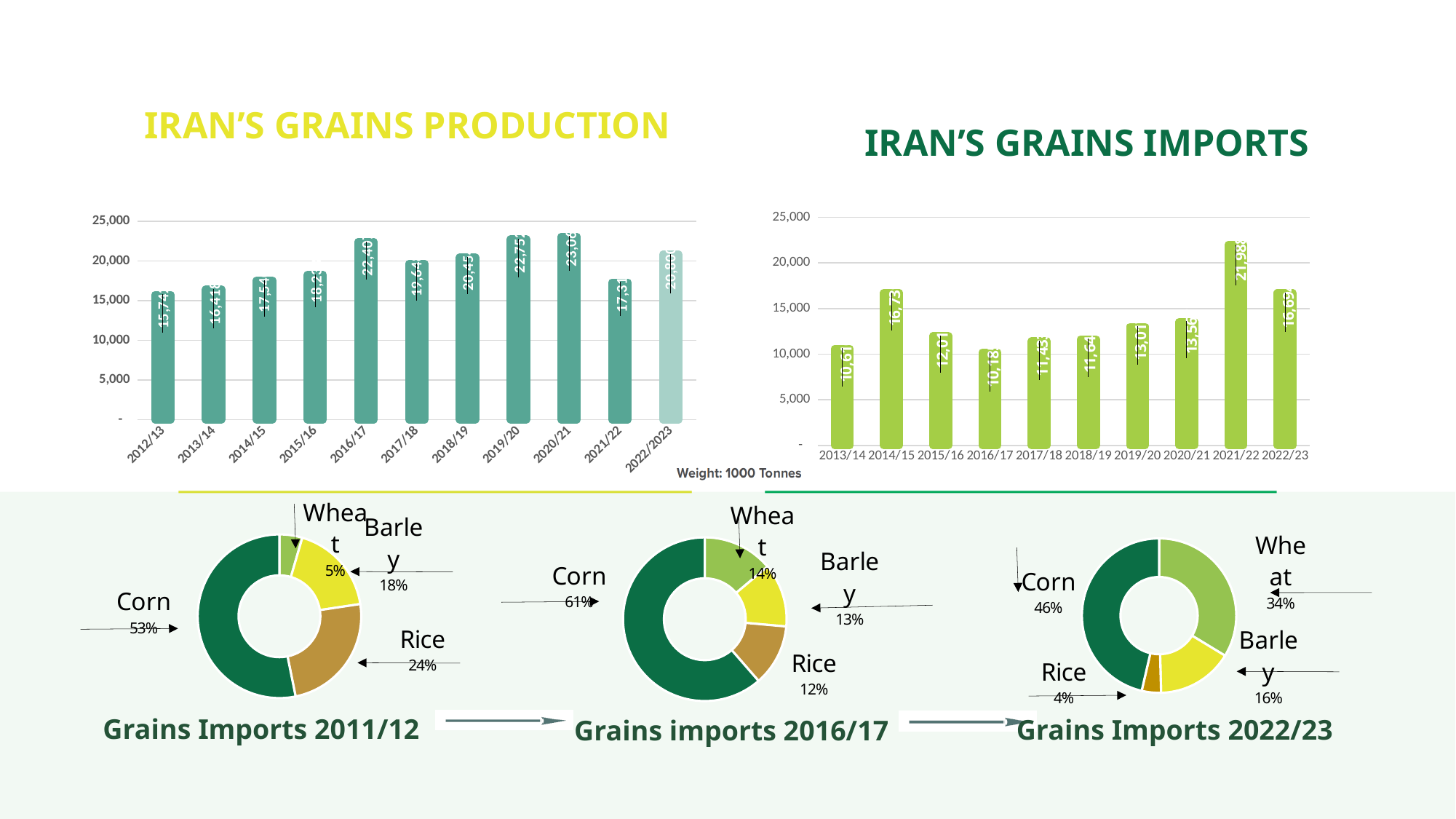
In the Iran's Grains Production chart, which year has the lowest production? 2012/13 In the Iran's Grains Production chart, which year has the highest production? 2020/21 In the Grains Imports 2022/23 donut chart, what is the difference between the Wheat share and the Rice share? 30 percentage points In the Iran's Grains Production chart, is the value for 2016/17 greater or less than 20,000? greater How many years are shown in the Iran's Grains Production chart? 11 In the Grains Imports 2011/12 donut chart, what share does Corn have? 53% In the Iran's Grains Imports chart, which year has the highest imports? 2021/22 What unit of weight is stated for the bar charts on the slide? 1000 Tonnes In the Iran's Grains Imports chart, is the value for 2016/17 greater or less than 15,000? less In the Grains imports 2016/17 donut chart, what share does Corn have? 61% How many years are shown in the Iran's Grains Imports chart? 10 What kind of chart is the Iran's Grains Imports chart? Bar chart